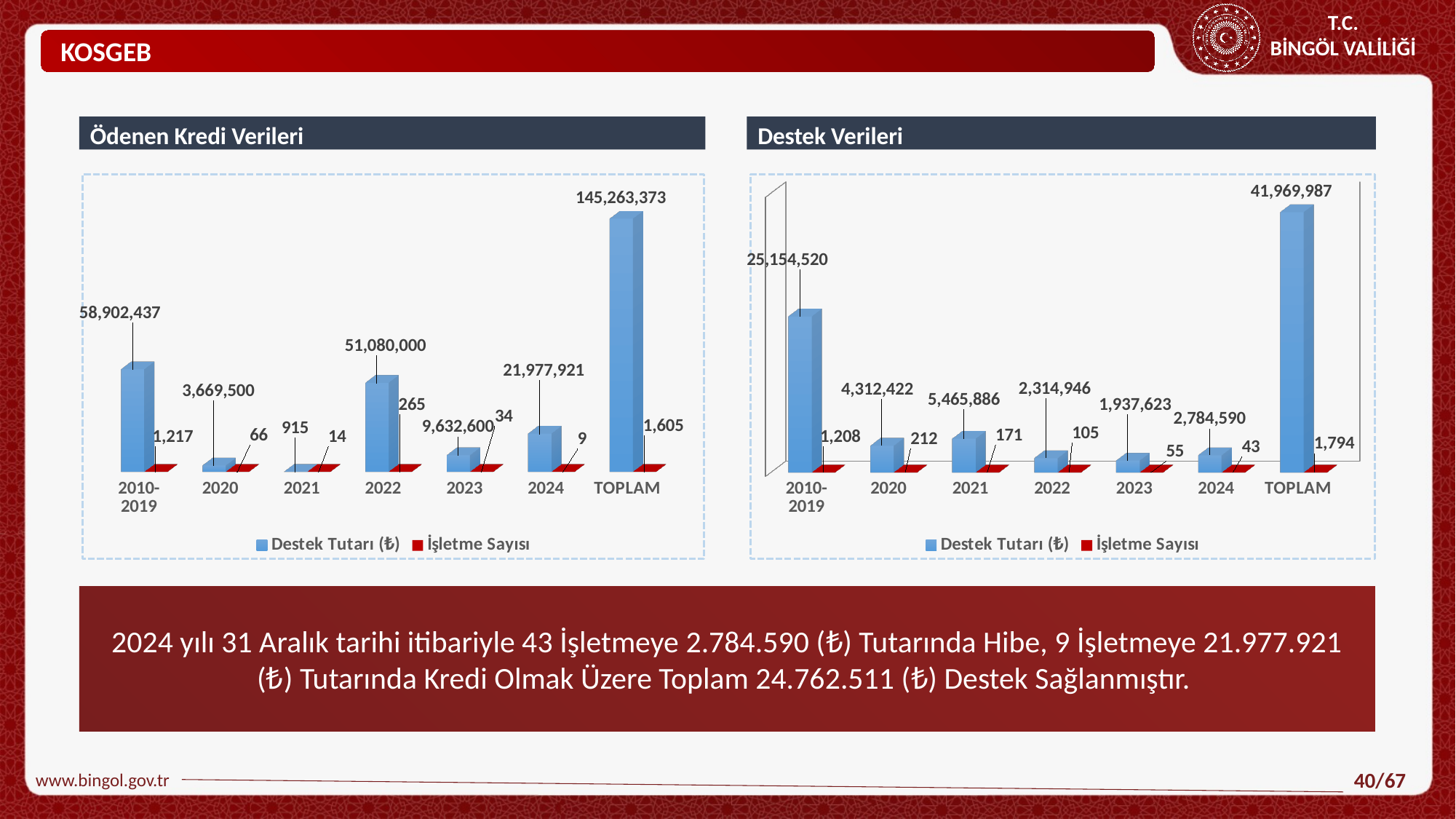
In the 'Destek Verileri' chart, what is the İşletme Sayısı value for TOPLAM? 1,794 In the 'Destek Verileri' chart, what is the Destek Tutarı (₺) value for 2021? 5,465,886 How many categories are shown on the x axis of the 'Destek Verileri' chart? 7 In the 'Destek Verileri' chart, is the Destek Tutarı (₺) for 2020 larger or smaller than that for 2021? smaller What type of chart is the 'Ödenen Kredi Verileri' chart? bar chart In the 'Ödenen Kredi Verileri' chart, which year category (excluding TOPLAM) has the lowest Destek Tutarı (₺)? 2021 In the 'Ödenen Kredi Verileri' chart, how many series does the legend list? 2 In the 'Destek Verileri' chart, which year category (excluding TOPLAM) has the highest Destek Tutarı (₺)? 2010-2019 In the 'Ödenen Kredi Verileri' chart, what is the difference between the Destek Tutarı (₺) for 2024 and 2023? 12,345,321 In the 'Destek Verileri' chart, what is the difference between the İşletme Sayısı for 2020 and 2021? 41 In the 'Ödenen Kredi Verileri' chart, what is the Destek Tutarı (₺) value for 2022? 51,080,000 In the 'Ödenen Kredi Verileri' chart, what is the İşletme Sayısı value for 2010-2019? 1,217